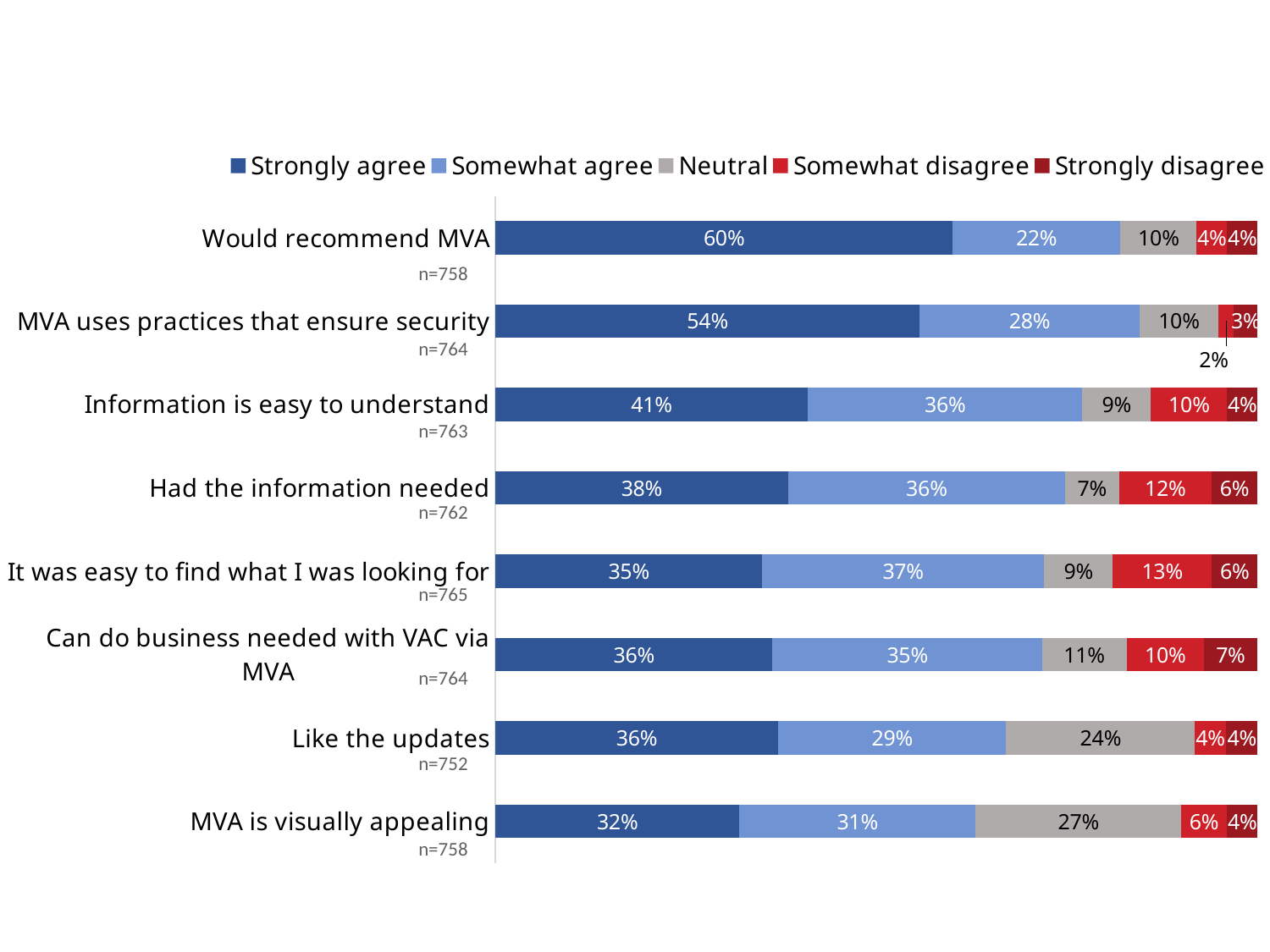
What percentage somewhat disagree that it was easy to find what they were looking for? 13% What is the difference between the Strongly agree values for "Would recommend MVA" and "MVA uses practices that ensure security"? 6% What percentage strongly agree that they would recommend MVA? 60% Which statement has the highest Strongly agree percentage? Would recommend MVA Which statement has the lowest Strongly agree percentage? MVA is visually appealing Which has a larger Neutral share: "Like the updates" or "Had the information needed"? Like the updates How many series does the legend list? 5 What kind of chart is shown on the slide? Stacked bar chart How many statements are shown in the chart? 8 What is the Neutral value for "MVA is visually appealing"? 27% What is the sample size (n) shown for "Like the updates"? n=752 What is the total of the stacked bar for "Had the information needed"? 99%